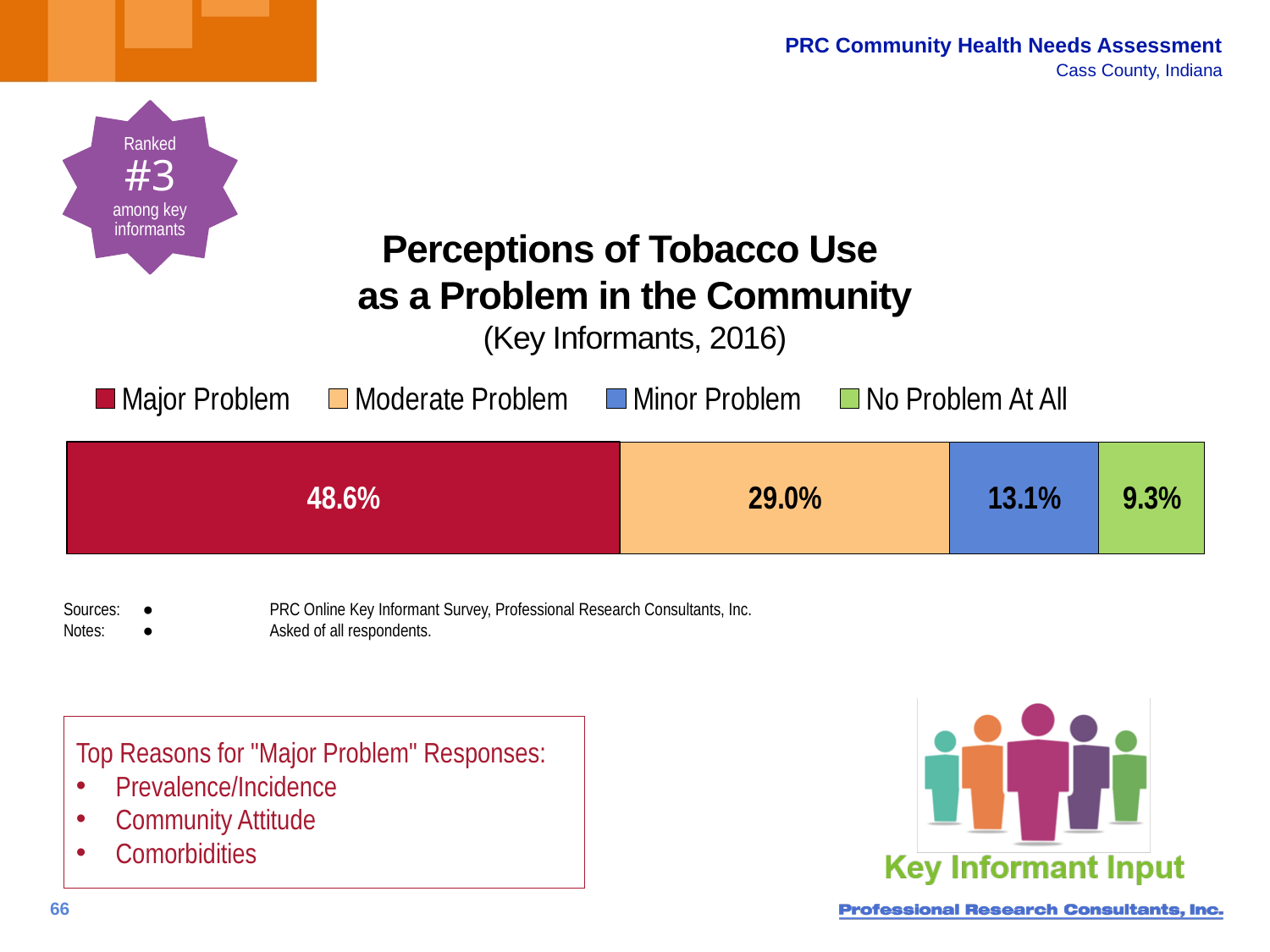
Which response category has the highest percentage? Major Problem What kind of chart is shown on the slide? Stacked bar chart What is the difference in percentage points between the Major Problem and Moderate Problem responses? 19.6 Which is larger, the Minor Problem share or the No Problem At All share? Minor Problem How many response categories does the legend list? 4 What percentage of key informants rated tobacco use as a Minor Problem? 13.1% What percentage of key informants said tobacco use is No Problem At All? 9.3% What colour represents the Major Problem segment? Red What percentage of key informants rated tobacco use as a Major Problem? 48.6% Which response category has the lowest percentage? No Problem At All What is the combined percentage of Major Problem and Moderate Problem responses? 77.6% What percentage of key informants rated tobacco use as a Moderate Problem? 29.0%